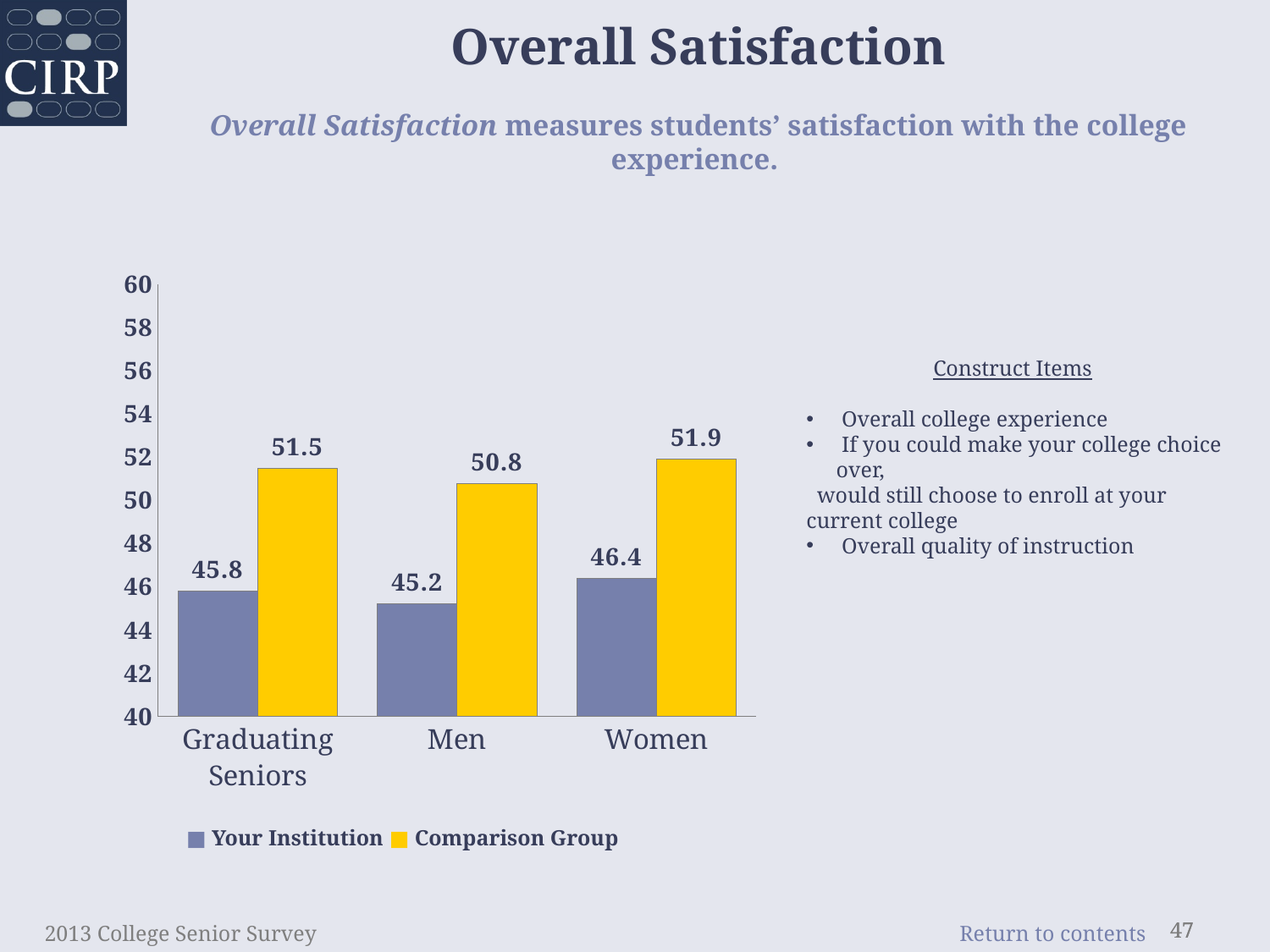
What is the value for Comparison Group for Men? 50.8 What kind of chart is shown on the slide? bar chart Is the Your Institution value for Women greater or less than 48? less What is the value for Your Institution for Graduating Seniors? 45.8 How many categories are shown on the x axis? 3 Which category has the highest Your Institution value? Women Which is larger for Men: Your Institution or Comparison Group? Comparison Group How many series does the legend list? 2 What colour represents the Comparison Group series? yellow What is the difference between the Comparison Group and Your Institution values for Graduating Seniors? 5.7 Which category has the lowest Comparison Group value? Men What is the value for Comparison Group for Women? 51.9